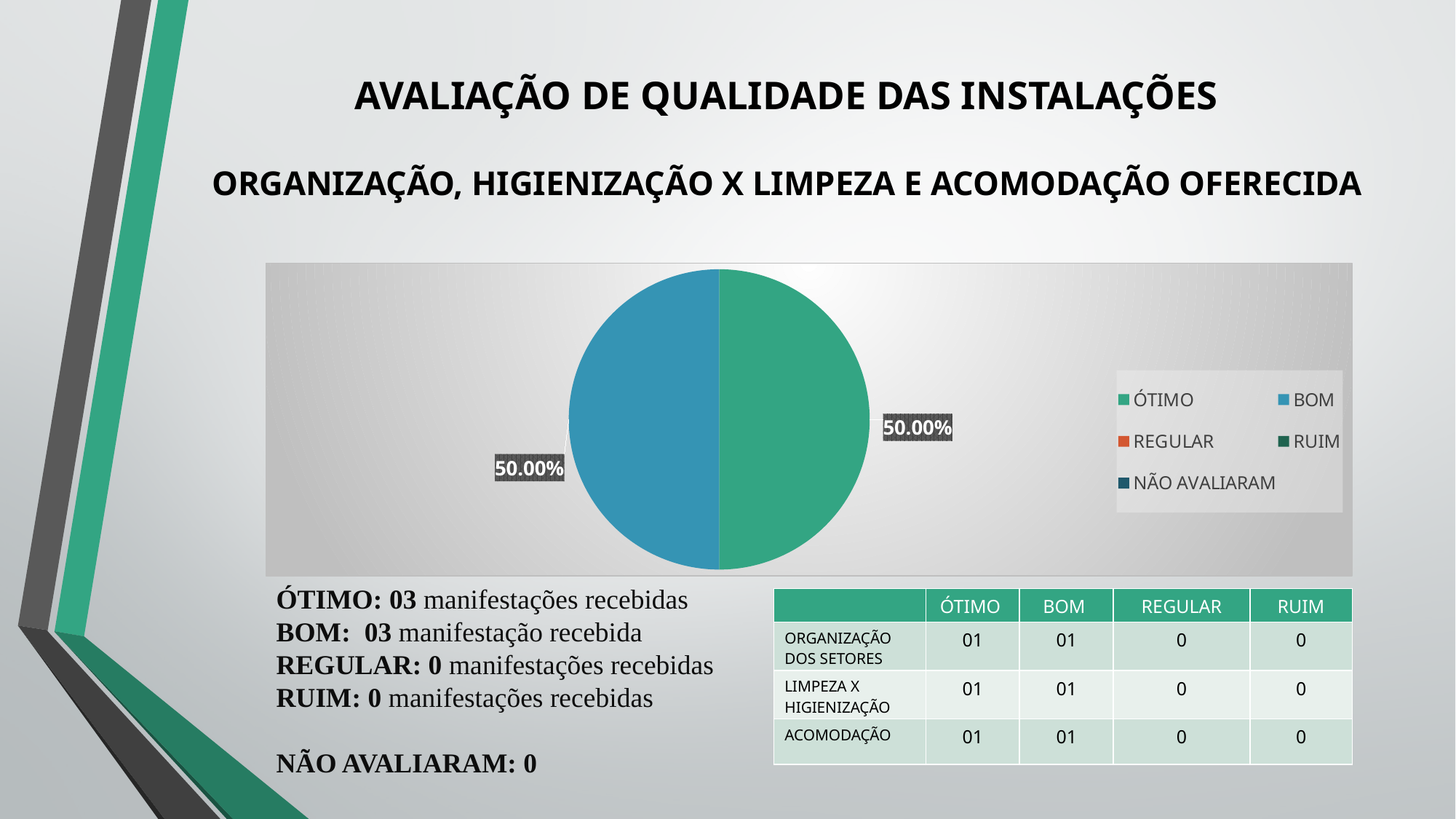
What is the combined share of the ÓTIMO and BOM slices in the pie chart? 100.00% What colour is the ÓTIMO slice in the pie chart? green How many slices are visible in the pie chart? 2 Which legend entry is shown in blue in the pie chart? BOM What is the difference between the ÓTIMO share and the BOM share in the pie chart? 0.00% What share of the pie chart does the BOM slice represent? 50.00% How many entries does the legend of the pie chart list? 5 What share of the pie chart does the ÓTIMO slice represent? 50.00% What kind of chart is shown on the slide? pie chart